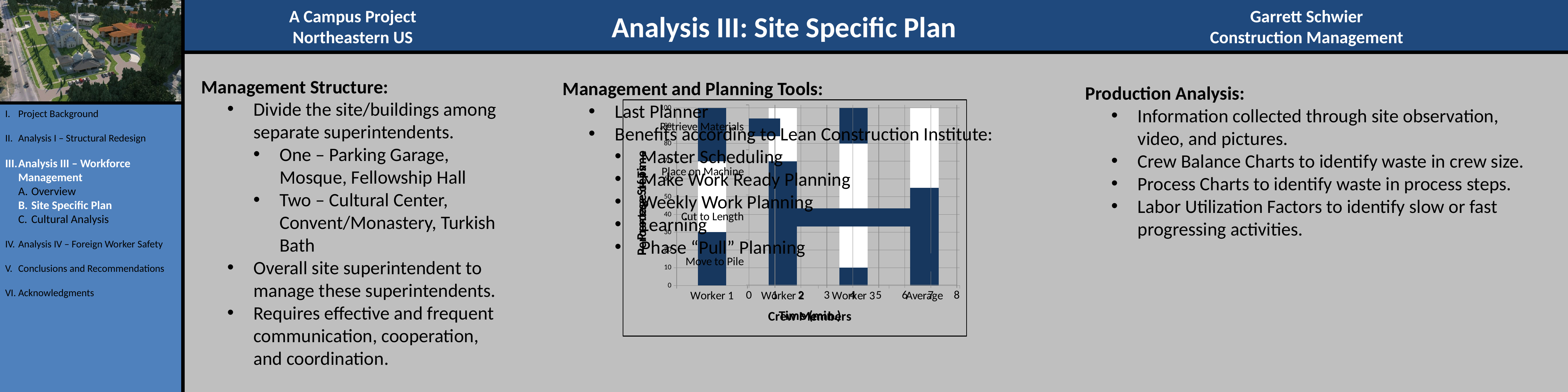
Is the dark blue bar for Average greater or less than 40? greater What kind of chart is shown on the slide? bar chart Which has the taller dark blue bar, Worker 1 or Worker 3? Worker 1 Which crew member has the shortest dark blue bar? Worker 3 Which crew member has the tallest dark blue bar? Worker 1 How many categories are shown along the x axis of the crew balance chart (Worker 1 through Average)? 4 What is the title of the x axis of the crew balance chart? Crew Members What is the highest tick value shown on the y axis of the chart? 100 Is the dark blue bar for Worker 1 greater or less than 90? greater